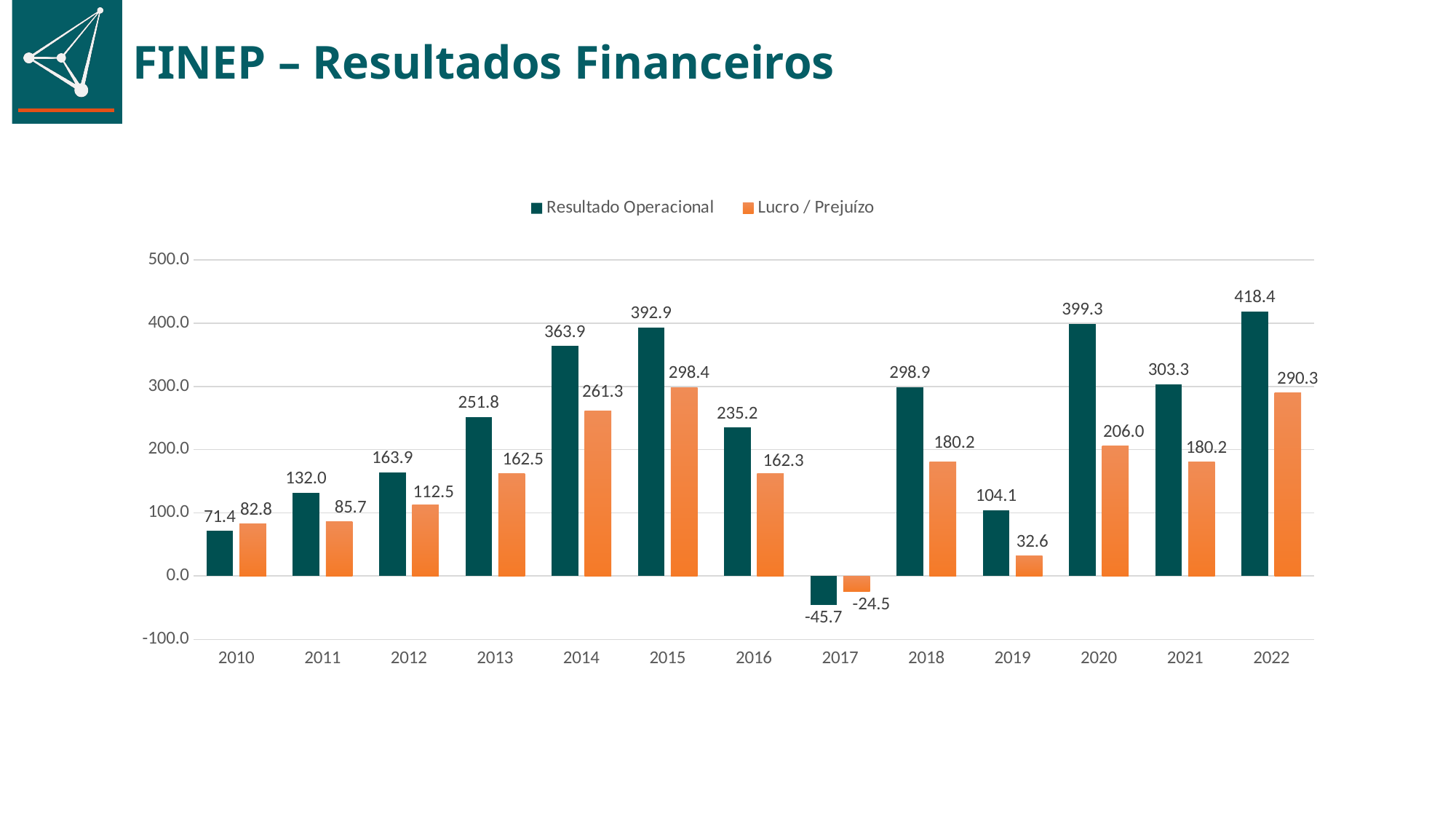
Which year has the highest Resultado Operacional? 2022 Does the Resultado Operacional rise or fall from 2016 to 2017? Fall What is the difference between Resultado Operacional and Lucro / Prejuízo in 2014? 102.6 Is the Resultado Operacional value for 2020 greater or less than 300.0? greater Which is larger in 2010, Resultado Operacional or Lucro / Prejuízo? Lucro / Prejuízo How many series does the legend list? 2 What is the Resultado Operacional value for 2015? 392.9 How many years are shown on the x axis? 13 What is the Lucro / Prejuízo value for 2019? 32.6 What kind of chart is shown on the slide? Bar chart What colour are the Lucro / Prejuízo bars? Orange Which year has the lowest Lucro / Prejuízo? 2017